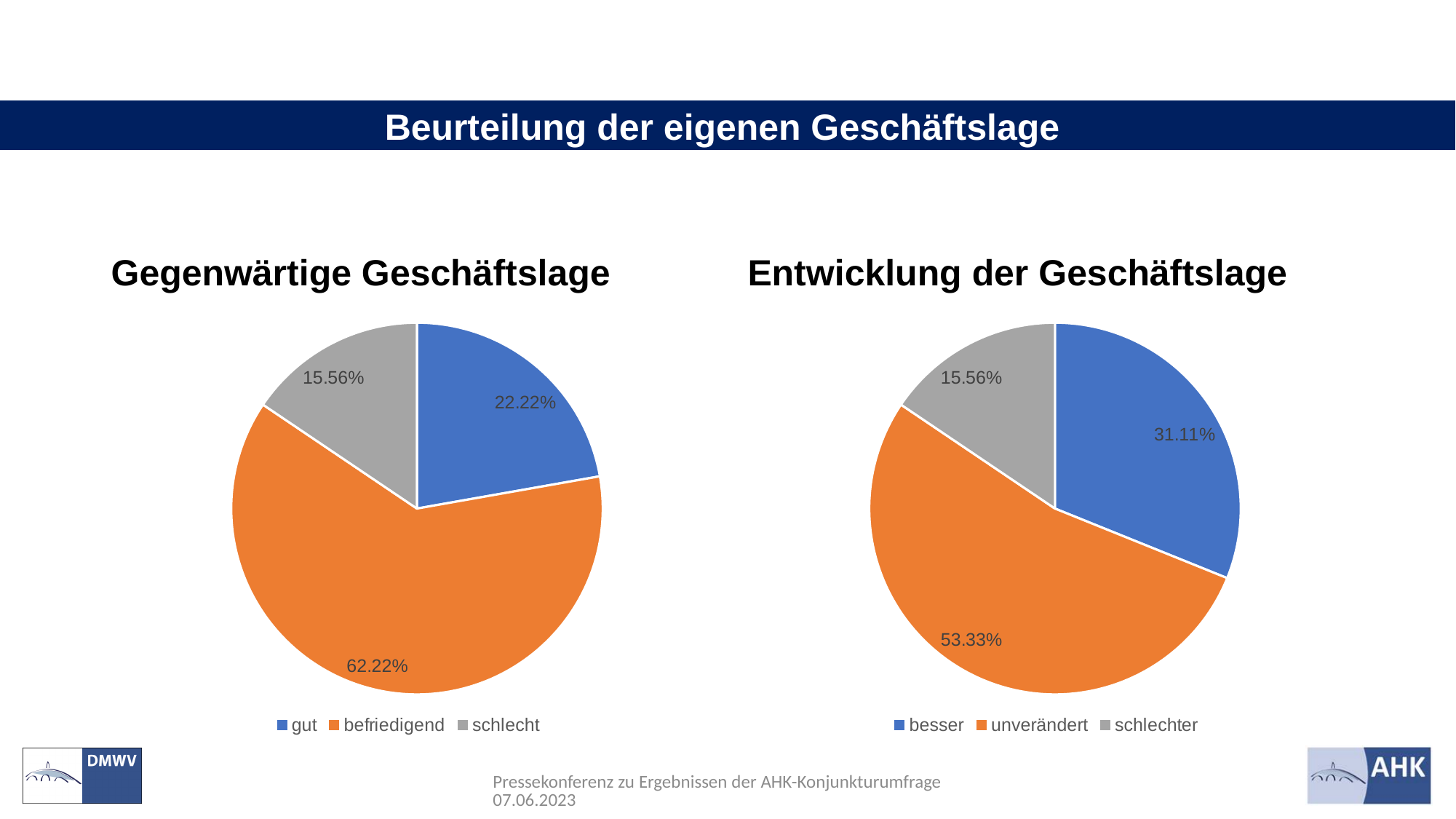
In the 'Entwicklung der Geschäftslage' chart, what share is labelled for 'unverändert'? 53.33% What kind of chart is 'Gegenwärtige Geschäftslage'? pie chart In the 'Gegenwärtige Geschäftslage' chart, what share is labelled for 'schlecht'? 15.56% In the 'Gegenwärtige Geschäftslage' chart, which category has the smallest slice? schlecht In the 'Gegenwärtige Geschäftslage' chart, what share is labelled for 'befriedigend'? 62.22% How many categories does the legend of the 'Entwicklung der Geschäftslage' chart list? 3 In the 'Entwicklung der Geschäftslage' chart, which colour represents 'schlechter'? grey In the 'Entwicklung der Geschäftslage' chart, which category has the largest slice? unverändert In the 'Entwicklung der Geschäftslage' chart, what share is labelled for 'besser'? 31.11% In the 'Gegenwärtige Geschäftslage' chart, what share is labelled for 'gut'? 22.22% In the 'Gegenwärtige Geschäftslage' chart, what is the difference between the 'befriedigend' and 'gut' shares? 40.00% In the 'Entwicklung der Geschäftslage' chart, which is larger: 'besser' or 'schlechter'? besser